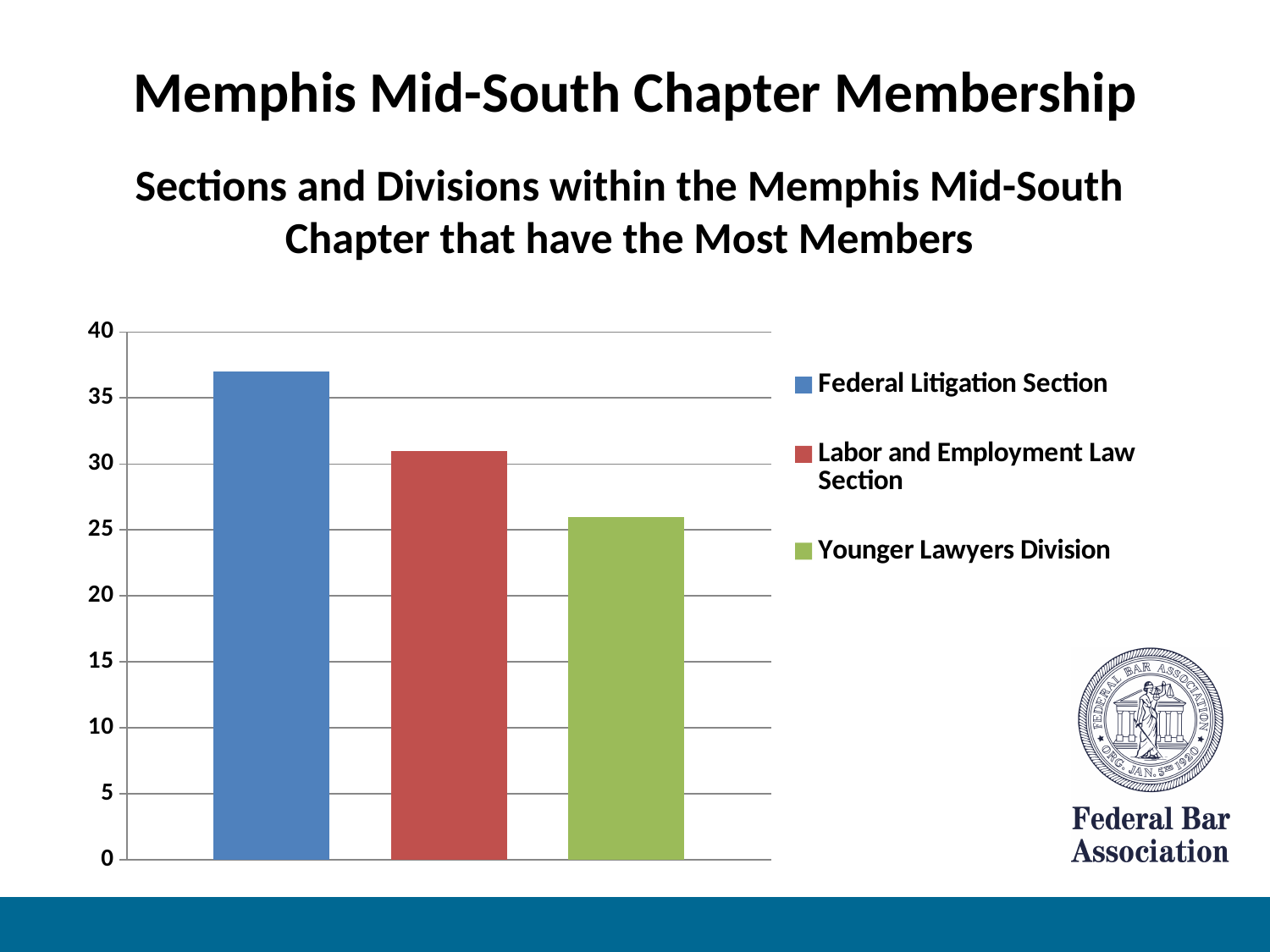
Is the value for the Labor and Employment Law Section greater or less than 30? greater What kind of chart is shown on the slide? bar chart Which section or division has the lowest number of members? Younger Lawyers Division How many entries does the legend list? 3 Is the value for the Younger Lawyers Division greater or less than 25? greater Is the value for the Younger Lawyers Division greater or less than 30? less Which section or division has the highest number of members? Federal Litigation Section Which has more members, the Federal Litigation Section or the Labor and Employment Law Section? Federal Litigation Section How many bars are plotted in the chart? 3 Which has more members, the Labor and Employment Law Section or the Younger Lawyers Division? Labor and Employment Law Section What colour is the bar for the Younger Lawyers Division? green